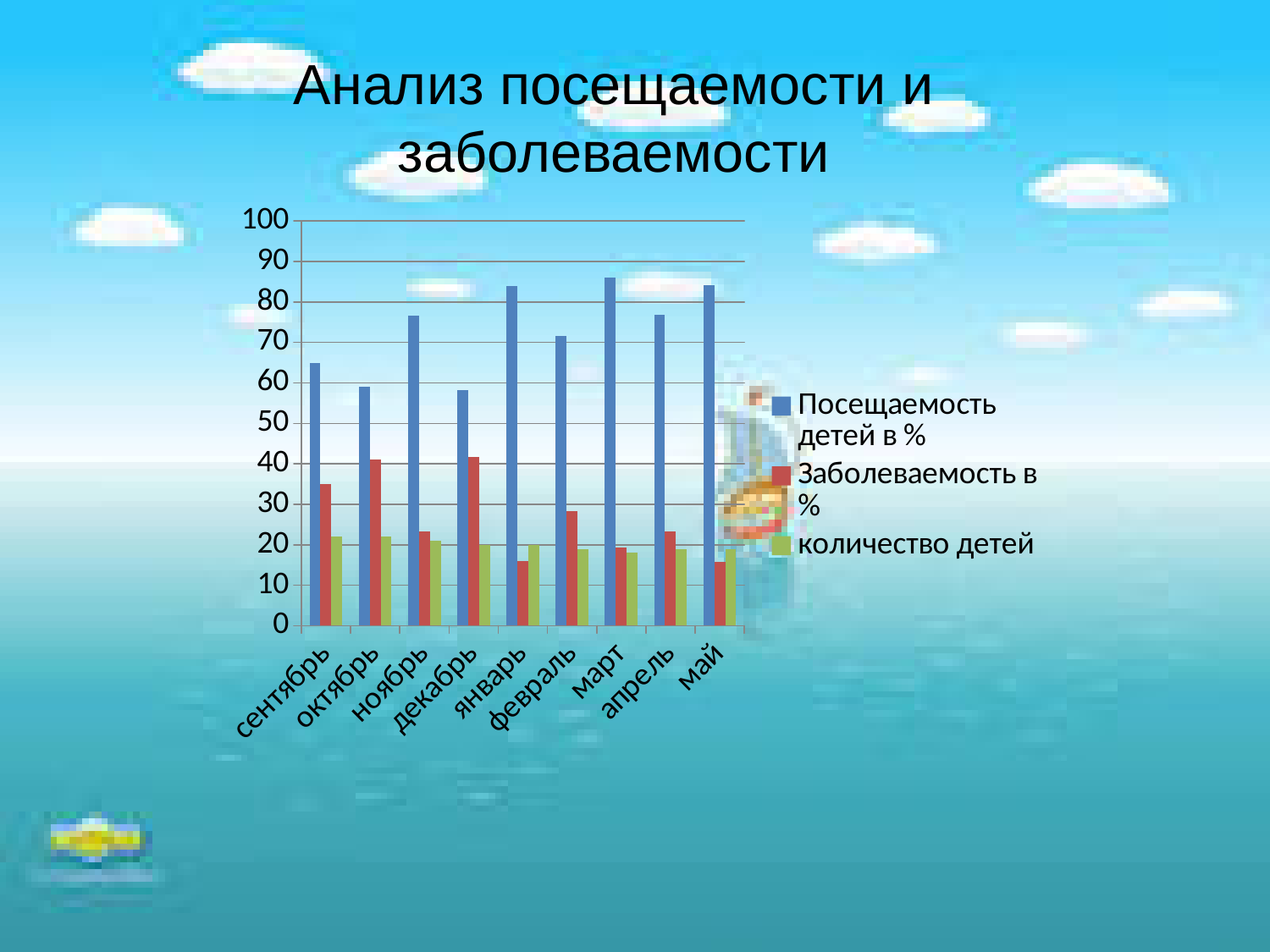
Is the value of Заболеваемость в % for сентябрь greater or less than 30? greater Which is larger, Посещаемость детей в % for ноябрь or for октябрь? ноябрь Is the value of Посещаемость детей в % for январь greater or less than 80? greater Which is larger, Заболеваемость в % for сентябрь or for ноябрь? сентябрь Is the value of Посещаемость детей в % for сентябрь greater or less than 60? greater What is the title of the slide? Анализ посещаемости и заболеваемости Which colour represents the series количество детей? green What kind of chart is shown on the slide? bar chart How many months are shown on the x axis? 9 How many series does the legend list? 3